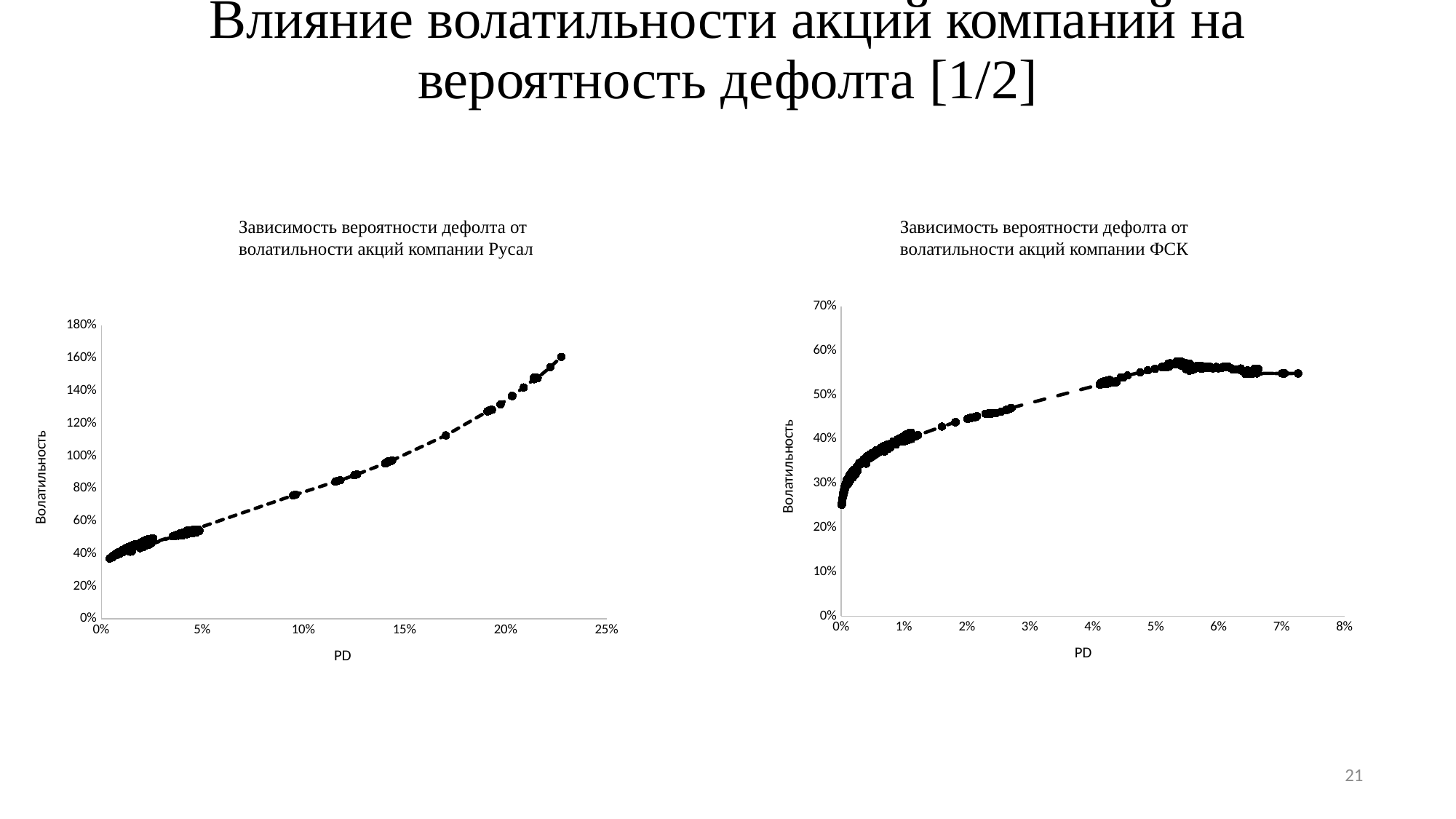
In the right chart (ФСК), does volatility generally rise or fall as PD increases from 0% to 5%? Rises Which chart reaches a higher maximum volatility, the left chart (Русал) or the right chart (ФСК)? The left chart (Русал) What is the label of the x axis on the left chart (Русал)? PD In the left chart (Русал), does volatility rise or fall as PD increases along the x axis? Rises In the left chart (Русал), is the volatility at a PD of 10% greater or less than 60%? greater What kind of chart is the left chart, titled 'Зависимость вероятности дефолта от волатильности акций компании Русал'? Scatter chart In the right chart (ФСК), is the volatility at a PD of 7% greater or less than 60%? less In the left chart (Русал), is the volatility at a PD of 10% greater or less than 100%? less What kind of chart is the right chart, titled 'Зависимость вероятности дефолта от волатильности акций компании ФСК'? Scatter chart What is the label of the y axis on the right chart (ФСК)? Волатильность